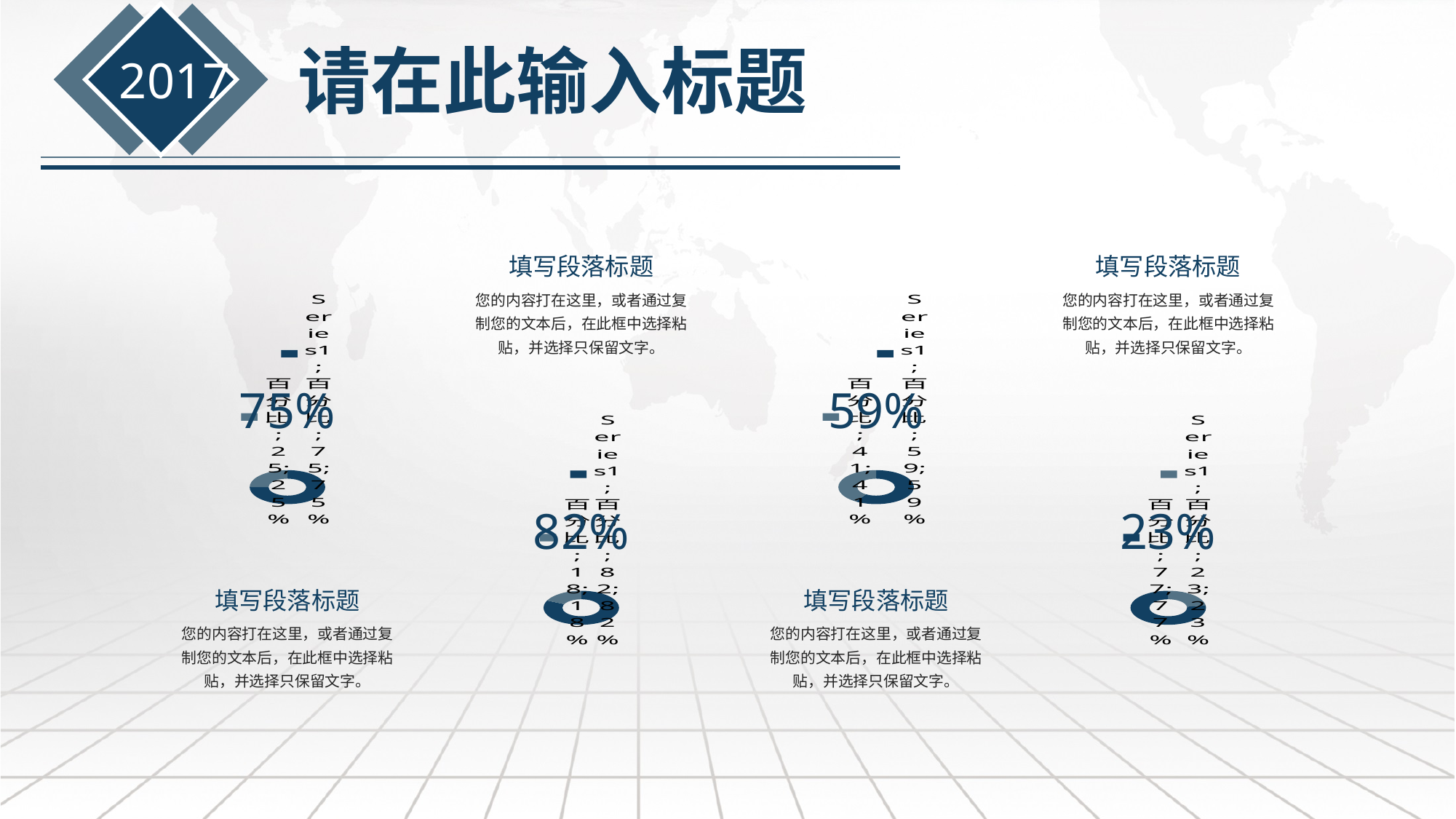
What is the difference between the percentages shown on the leftmost and the third doughnut charts? 16 percentage points How many doughnut charts are shown on the slide? 4 Which shows a larger percentage, the leftmost doughnut chart or the third doughnut chart from the left? the leftmost (75%) What percentage is displayed on the third doughnut chart from the left? 59% Which of the four doughnut charts shows the lowest percentage? the rightmost (23%) What type of chart is used for the four small charts on the slide? doughnut chart What is the difference between the percentage on the second chart from the left and the percentage on the rightmost chart? 59 percentage points What percentage is displayed on the leftmost doughnut chart? 75% What percentage is displayed on the rightmost doughnut chart? 23% What percentage is displayed on the second doughnut chart from the left? 82% Which of the four doughnut charts shows the highest percentage? the second from the left (82%)